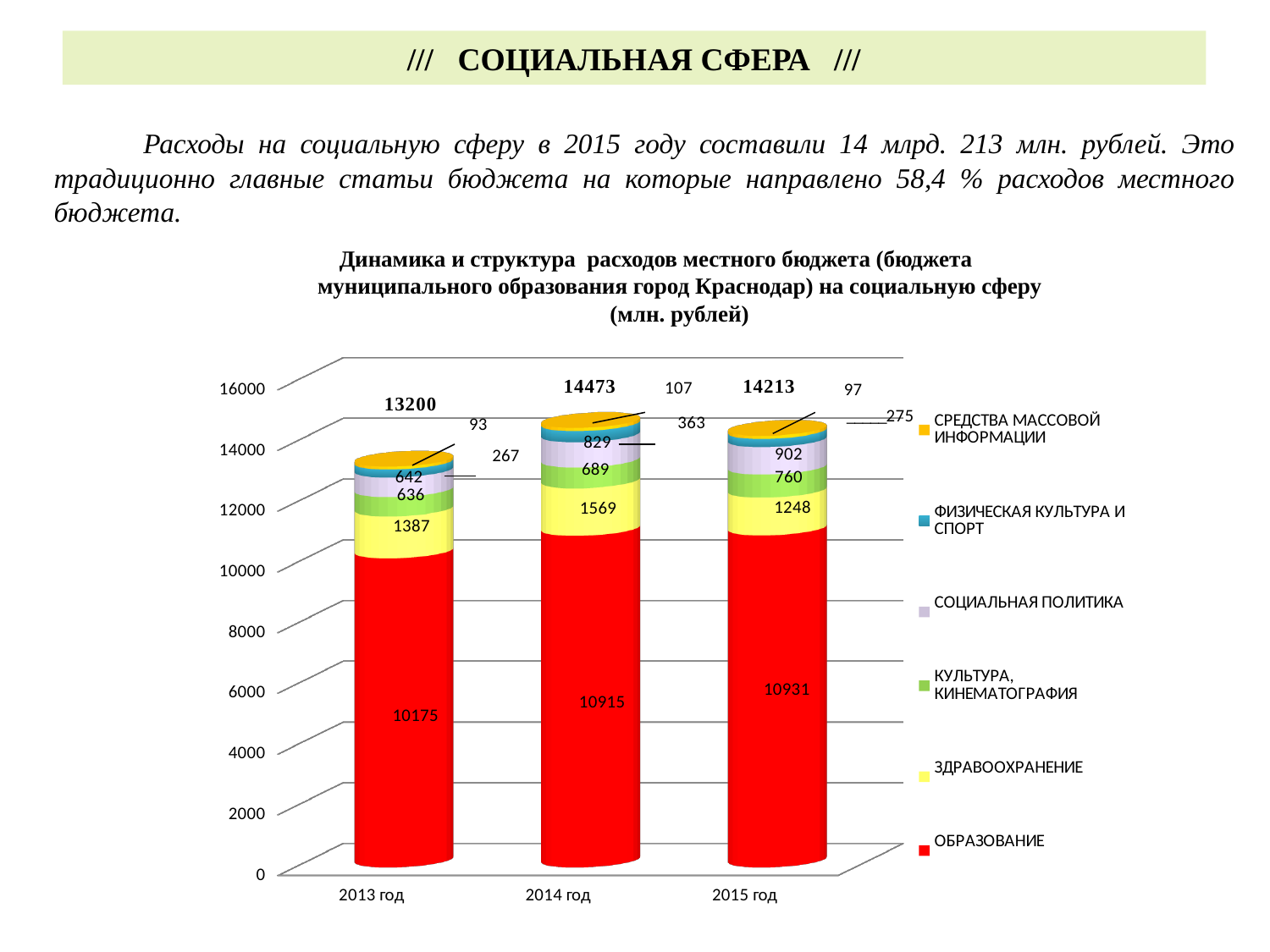
What is the value for СОЦИАЛЬНАЯ ПОЛИТИКА in 2013 год? 642 What type of chart is shown on the slide? stacked bar chart Which year has the highest total social sphere expenditure? 2014 год What is the value for ОБРАЗОВАНИЕ in 2015 год? 10931 How many years (categories) are shown on the x axis? 3 What is the total of the stacked bar for 2014 год? 14473 Which is larger: ЗДРАВООХРАНЕНИЕ in 2013 год or in 2015 год? 2013 год Which year has the lowest total social sphere expenditure? 2013 год What is the difference between the ОБРАЗОВАНИЕ values for 2014 год and 2013 год? 740 What is the value for ЗДРАВООХРАНЕНИЕ in 2014 год? 1569 Does the value for КУЛЬТУРА, КИНЕМАТОГРАФИЯ rise or fall from 2013 год to 2015 год? rise How many series does the legend list? 6